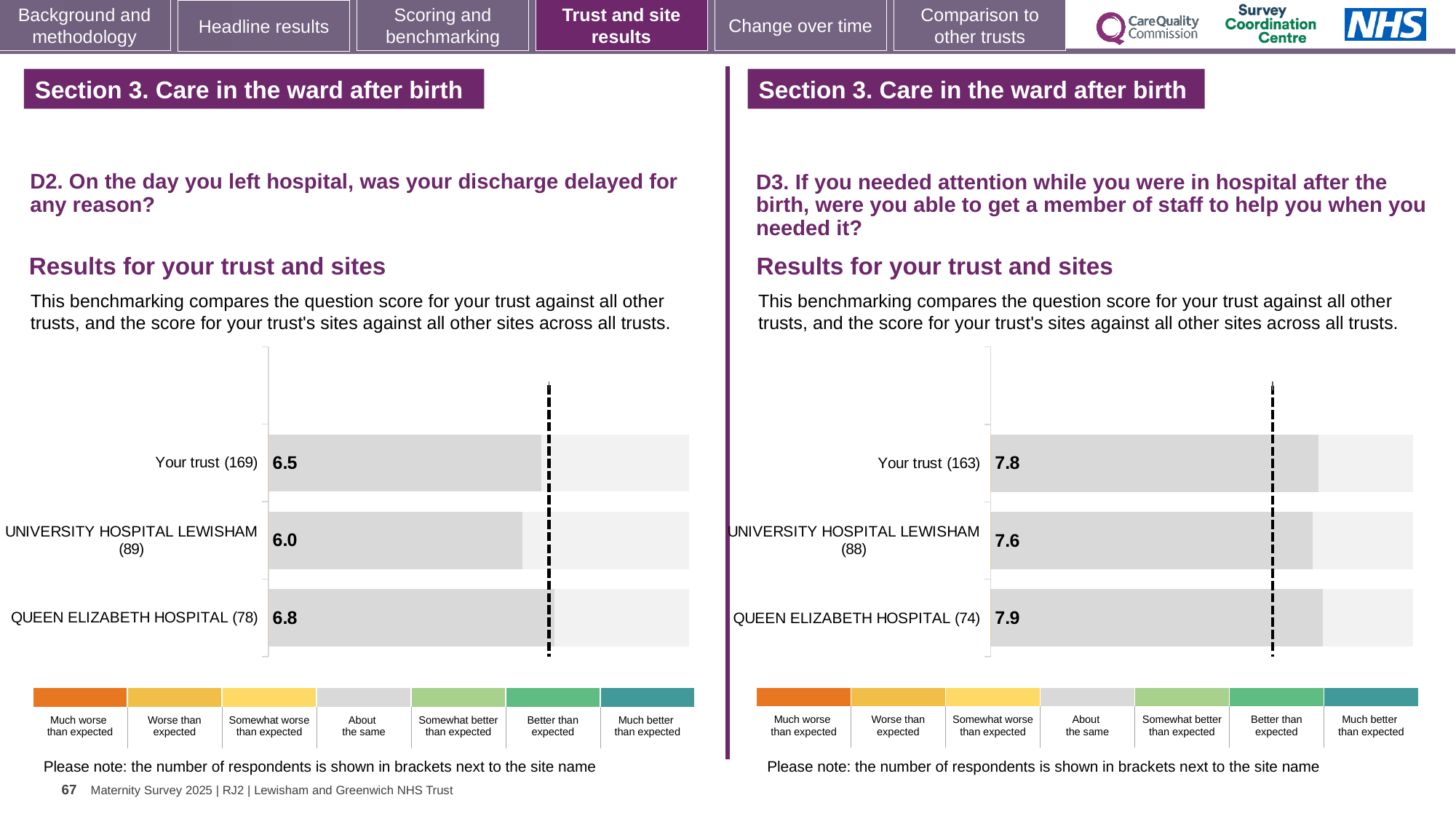
In the D3 chart (right), which has the larger score, Your trust or UNIVERSITY HOSPITAL LEWISHAM? Your trust In the D2 chart (left), which site or trust has the highest score? QUEEN ELIZABETH HOSPITAL In the D2 chart (left), which site or trust has the lowest score? UNIVERSITY HOSPITAL LEWISHAM In the D3 chart (right), what is the score for QUEEN ELIZABETH HOSPITAL? 7.9 In the D2 chart (left), what is the score for UNIVERSITY HOSPITAL LEWISHAM? 6.0 In the D2 chart (left), how many respondents are shown in brackets for Your trust? 169 What type of chart is used in the D3 chart (right)? Bar chart In the D3 chart (right), how many bars are plotted? 3 In the D2 chart (left), what is the score for Your trust? 6.5 In the D3 chart (right), what is the score for Your trust? 7.8 In the D2 chart (left), what is the difference between the scores for QUEEN ELIZABETH HOSPITAL and UNIVERSITY HOSPITAL LEWISHAM? 0.8 In the D3 chart (right), which site or trust has the lowest score? UNIVERSITY HOSPITAL LEWISHAM